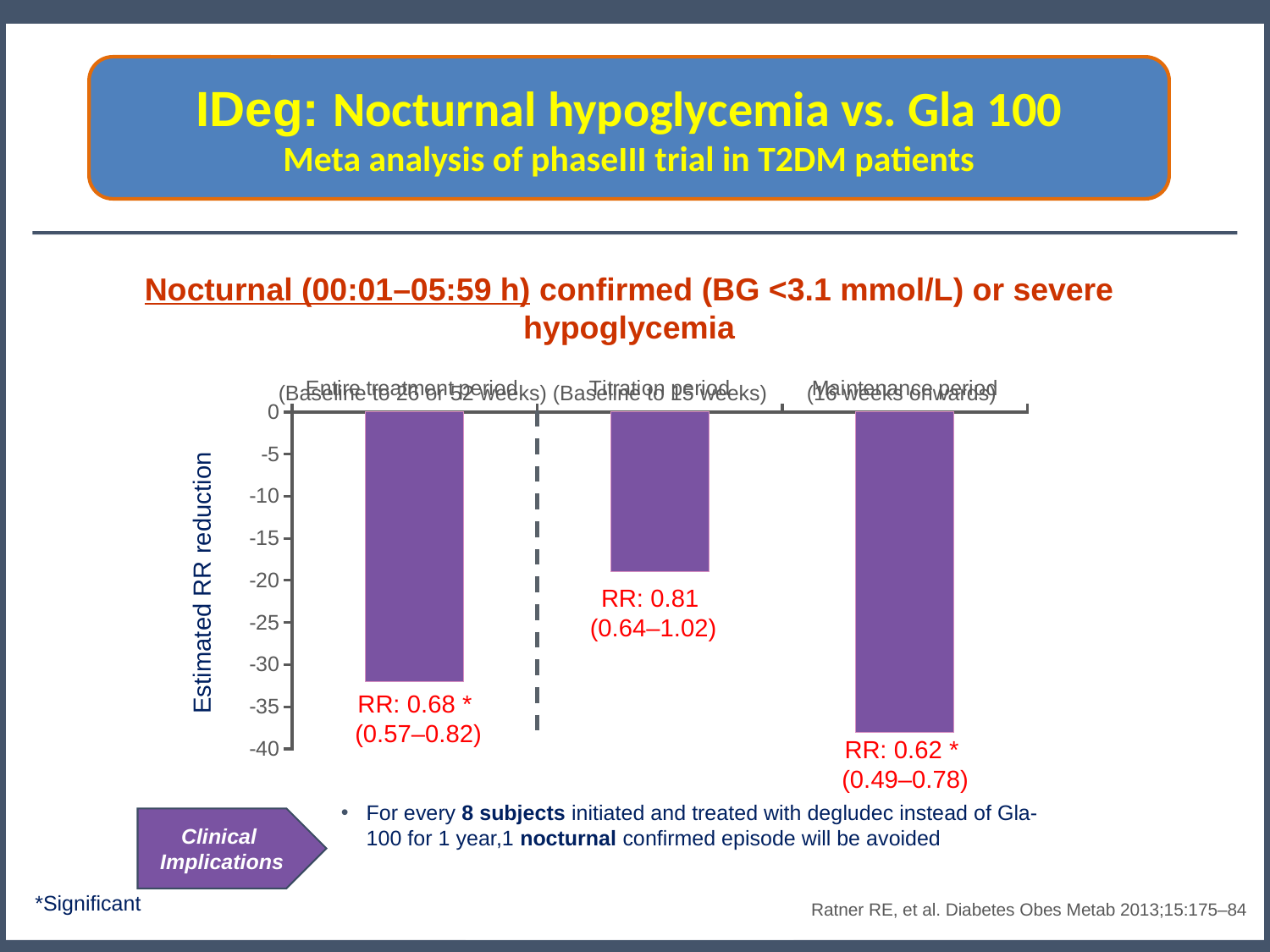
What is the RR value labelled on the bar for the Entire treatment period? RR: 0.68 * Which period shows the smallest estimated RR reduction (shortest bar)? Titration period What kind of chart is shown on the slide? bar chart What is the title of the vertical axis? Estimated RR reduction What is the RR value labelled on the bar for the Titration period? RR: 0.81 How many bars (periods) are plotted in the chart? 3 What confidence interval is printed under the RR for the Maintenance period? (0.49–0.78) What confidence interval is printed under the RR for the Titration period? (0.64–1.02) What is the RR value labelled on the bar for the Maintenance period? RR: 0.62 * Is the value for the Titration period greater or less than -25 on the axis? greater Is the value for the Maintenance period greater or less than -35 on the axis? less Which period's bar extends the lowest on the Estimated RR reduction axis? Maintenance period